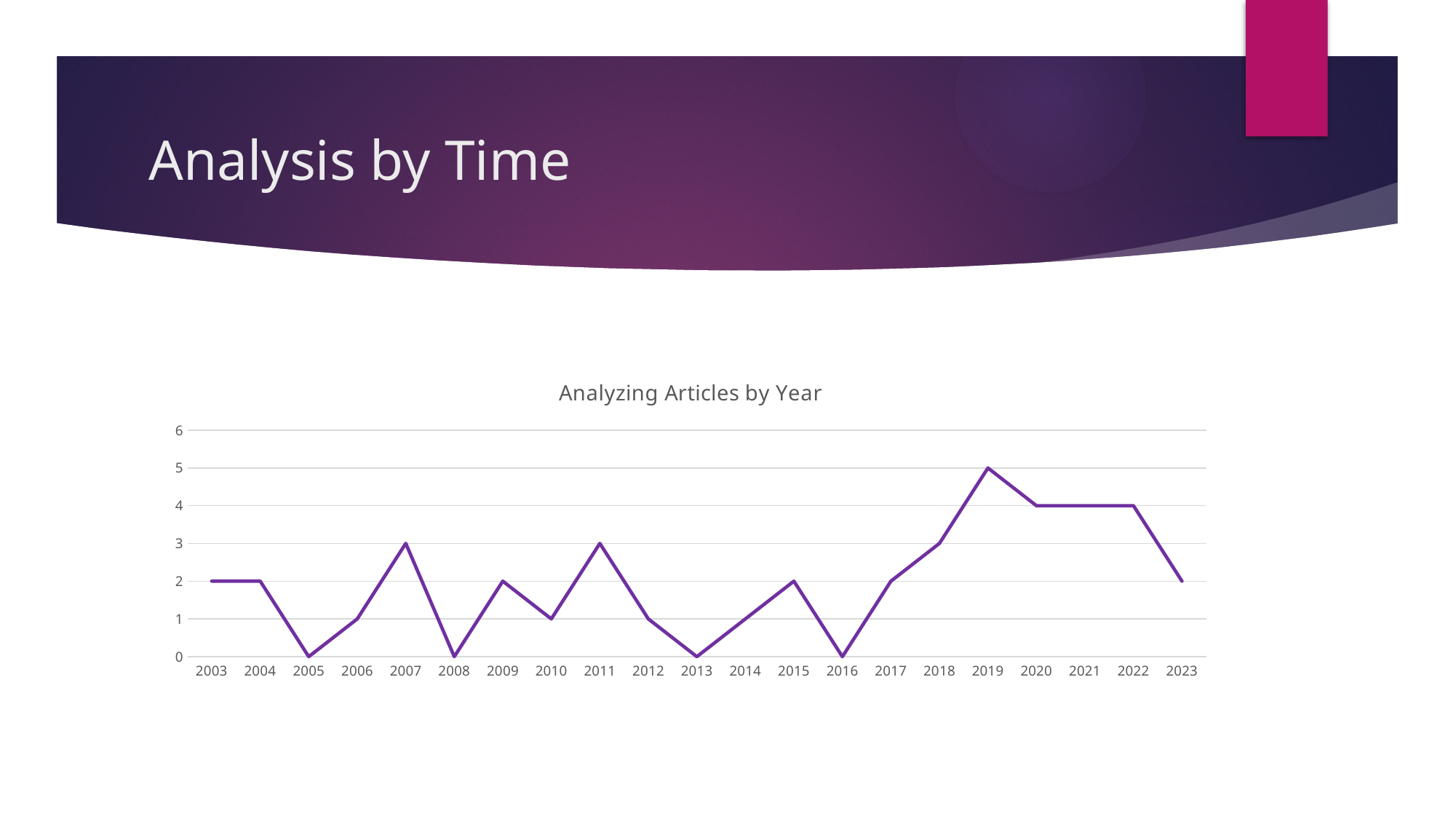
What is the value for 2007? 3 What is the value for 2005? 0 What is the title of the chart? Analyzing Articles by Year Which year has the highest value? 2019 What is the value for 2019? 5 What type of chart is shown on the slide? Line chart What is the value for 2023? 2 What is the difference between the values for 2019 and 2020? 1 What is the value for 2021? 4 Does the value rise or fall from 2022 to 2023? Fall Which is larger, the value for 2011 or the value for 2012? 2011 How many years are plotted on the x axis? 21